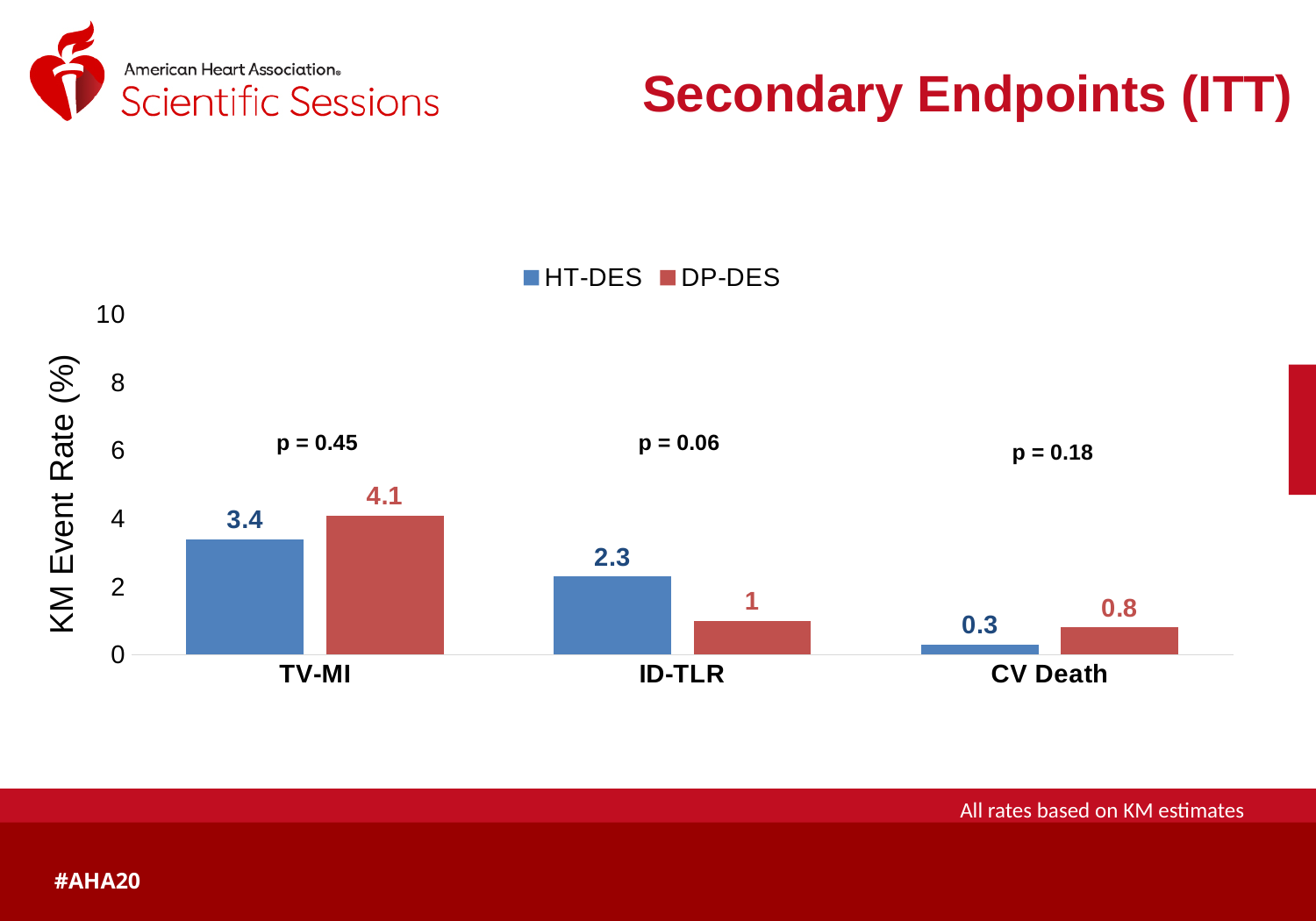
How many categories are shown on the x axis? 3 What is the KM event rate for HT-DES in the TV-MI category? 3.4 What is the KM event rate for HT-DES in the CV Death category? 0.3 What is the KM event rate for DP-DES in the ID-TLR category? 1 Which is larger for ID-TLR, the HT-DES value or the DP-DES value? HT-DES What is the difference between the DP-DES and HT-DES values for TV-MI? 0.7 Is the DP-DES value for TV-MI greater or less than 4? greater What kind of chart is shown on the slide? bar chart What is the p-value shown above the ID-TLR bars? p = 0.06 Which category has the lowest HT-DES value? CV Death Which category has the highest DP-DES value? TV-MI How many series does the legend list? 2